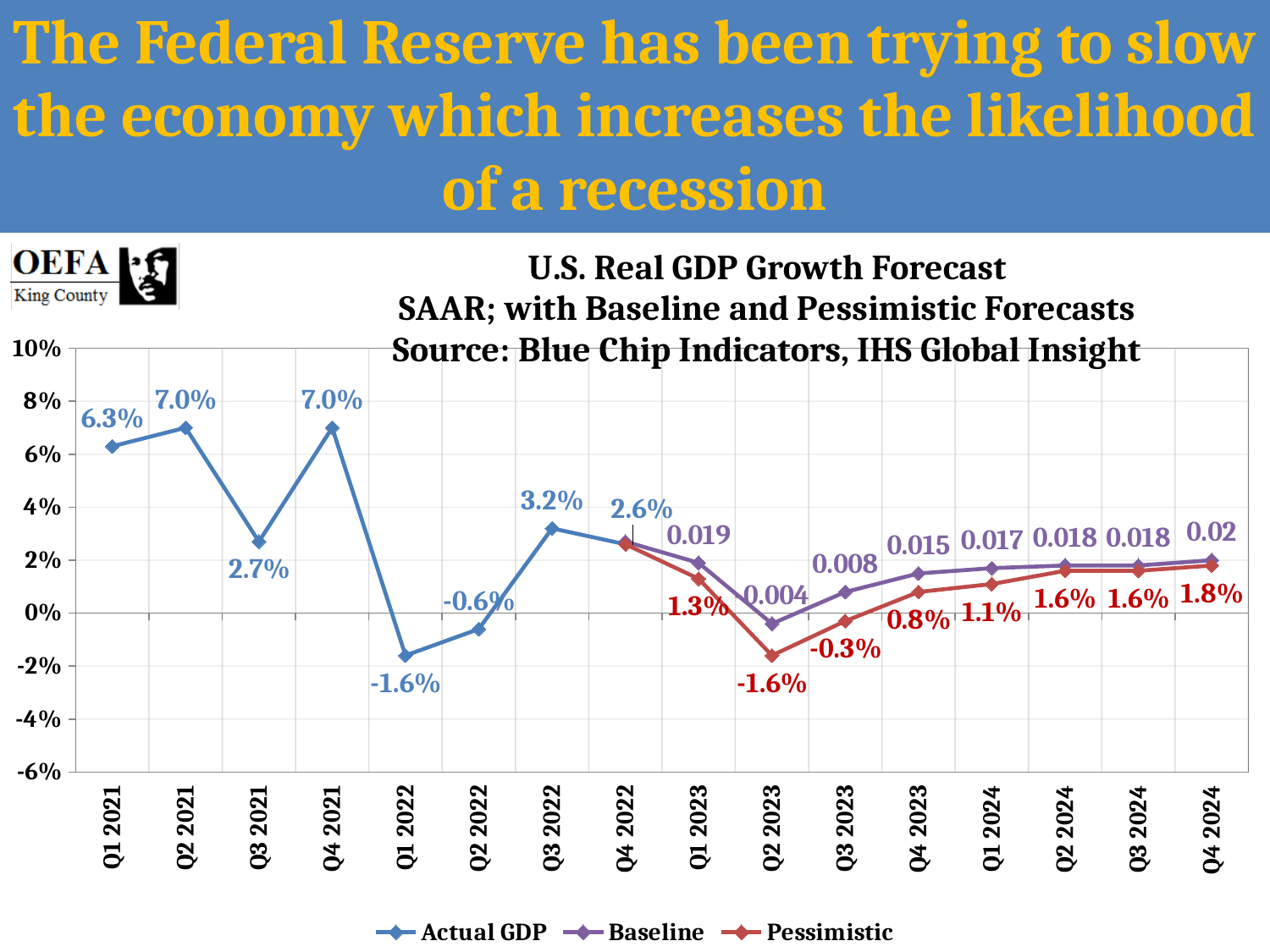
What are the three series named in the legend? Actual GDP, Baseline, Pessimistic What is the Actual GDP value for Q1 2021? 6.3% What is the Baseline forecast value for Q4 2024? 0.02 What is the Pessimistic forecast value for Q2 2023? -1.6% In which quarter does the Pessimistic series reach its highest value? Q4 2022 What kind of chart is shown on the slide? Line chart In which quarter is the Actual GDP series at its lowest? Q1 2022 How many series does the legend list? 3 What is the difference between the Actual GDP values for Q3 2022 and Q4 2022? 0.6 percentage points How many quarters are shown on the x axis? 16 Does the Pessimistic series rise or fall from Q2 2023 to Q4 2024? Rises In Q3 2023, which series has the higher value, Baseline or Pessimistic? Baseline